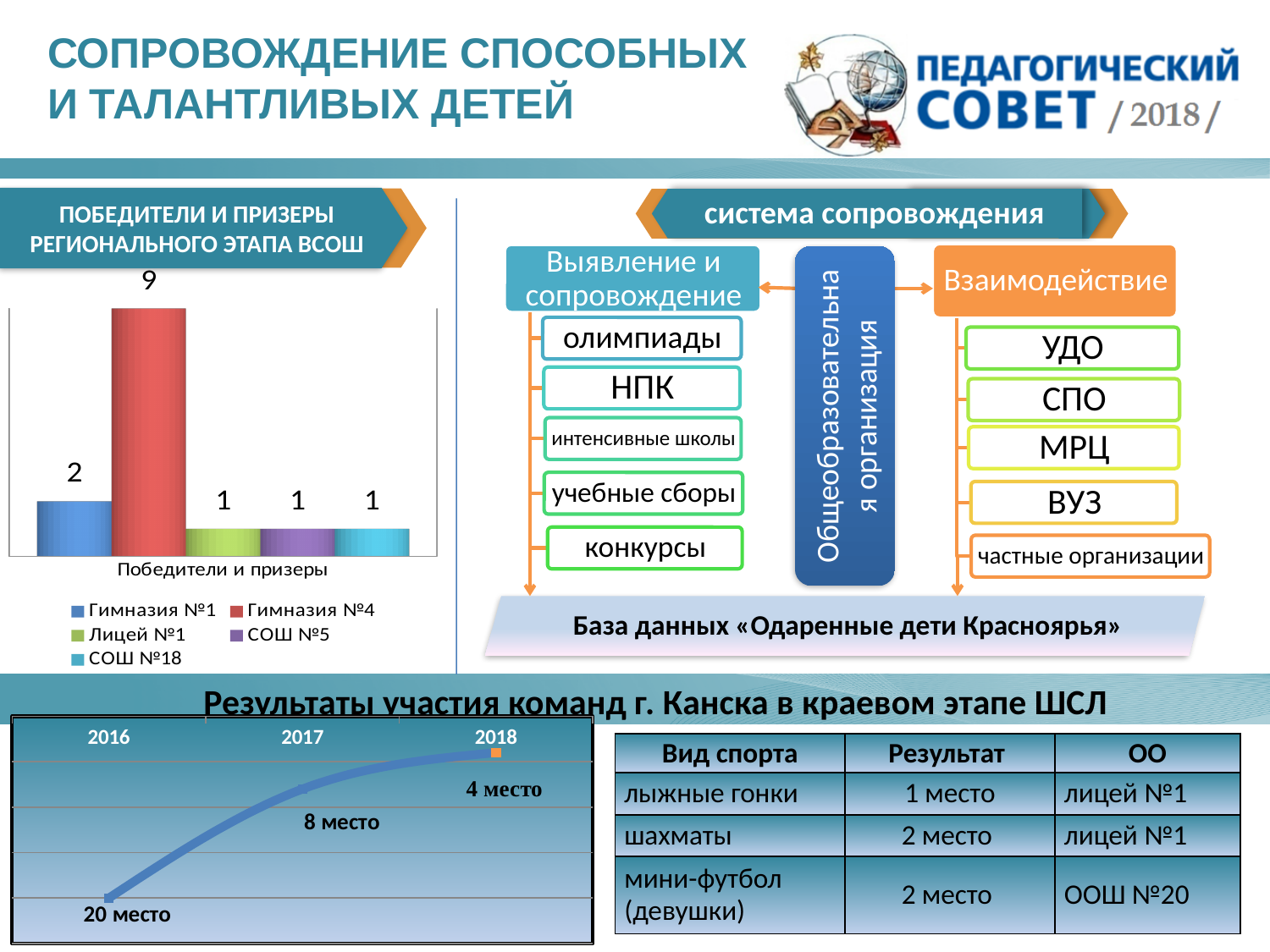
On the line chart 'Результаты участия команд г. Канска в краевом этапе ШСЛ', what is the result for 2016? 20 место On the bar chart 'Победители и призеры регионального этапа ВСОШ', how many series does the legend list? 5 On the bar chart 'Победители и призеры регионального этапа ВСОШ', what is the value for Лицей №1? 1 On the bar chart 'Победители и призеры регионального этапа ВСОШ', what is the category label on the x axis? Победители и призеры On the bar chart 'Победители и призеры регионального этапа ВСОШ', what is the value for Гимназия №4? 9 On the line chart 'Результаты участия команд г. Канска в краевом этапе ШСЛ', what is the result for 2018? 4 место On the line chart 'Результаты участия команд г. Канска в краевом этапе ШСЛ', how many years are plotted? 3 On the bar chart 'Победители и призеры регионального этапа ВСОШ', what is the difference between the values for Гимназия №4 and Гимназия №1? 7 On the bar chart 'Победители и призеры регионального этапа ВСОШ', which is larger: the value for Гимназия №1 or the value for СОШ №5? Гимназия №1 On the bar chart 'Победители и призеры регионального этапа ВСОШ', what is the value for Гимназия №1? 2 What kind of chart is 'Победители и призеры регионального этапа ВСОШ'? bar chart On the bar chart 'Победители и призеры регионального этапа ВСОШ', which series has the highest value? Гимназия №4